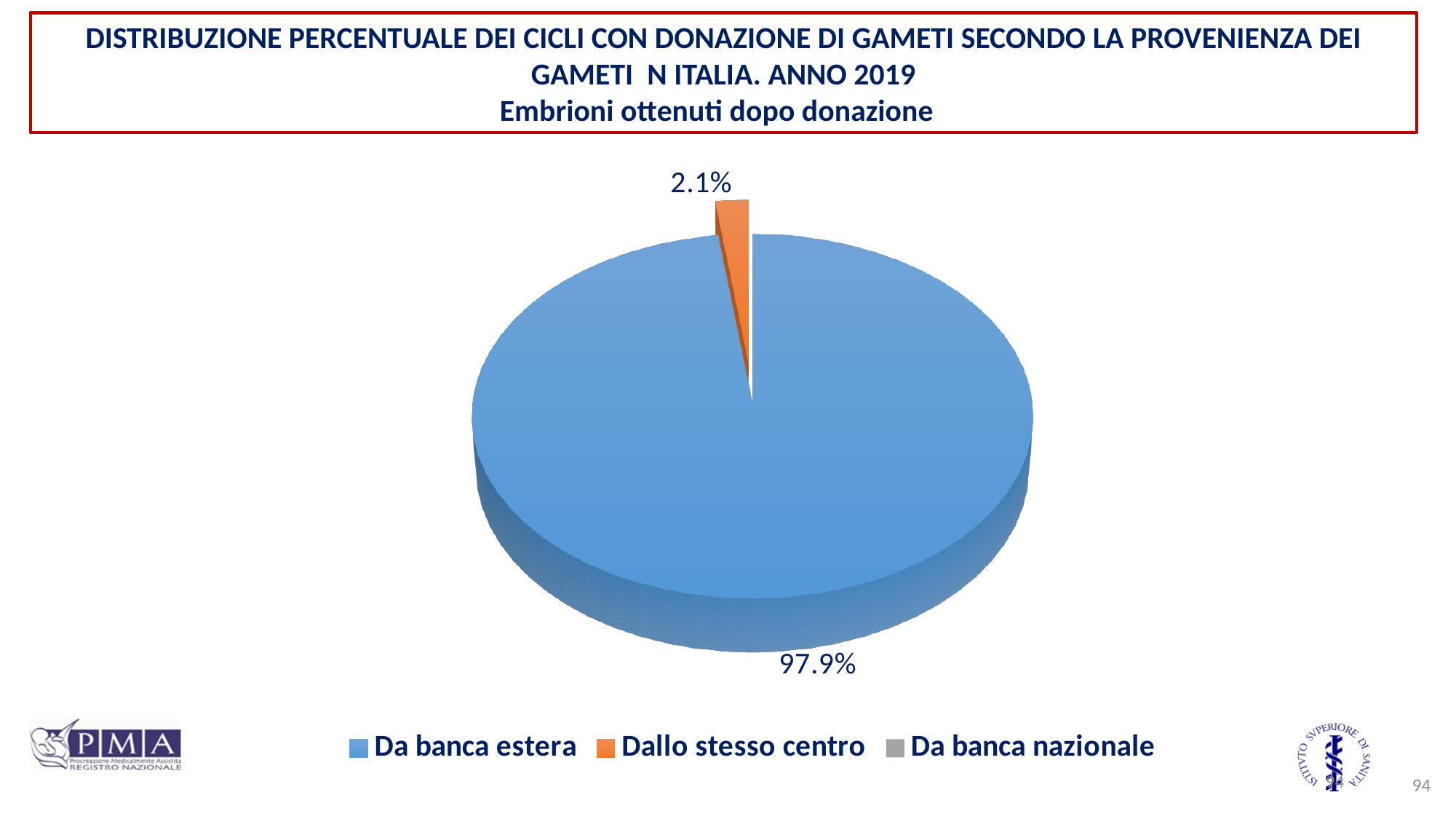
What is the difference in percentage points between the "Da banca estera" slice and the "Dallo stesso centro" slice? 95.8 What kind of chart is shown on the slide? pie chart What colour is the slice for "Dallo stesso centro"? orange Which of the two labelled slices is smaller, "Da banca estera" or "Dallo stesso centro"? Dallo stesso centro Which category has the largest slice of the pie? Da banca estera Which is larger, the slice for "Da banca estera" or the slice for "Dallo stesso centro"? Da banca estera What percentage of the pie is labelled for "Dallo stesso centro"? 2.1% How many entries does the legend list? 3 What share of the pie does the "Da banca estera" slice represent? 97.9% What is the subtitle of the chart, shown on the third line of the title box? Embrioni ottenuti dopo donazione What percentage of the pie is labelled for "Da banca estera"? 97.9% Which year does the chart title refer to? 2019